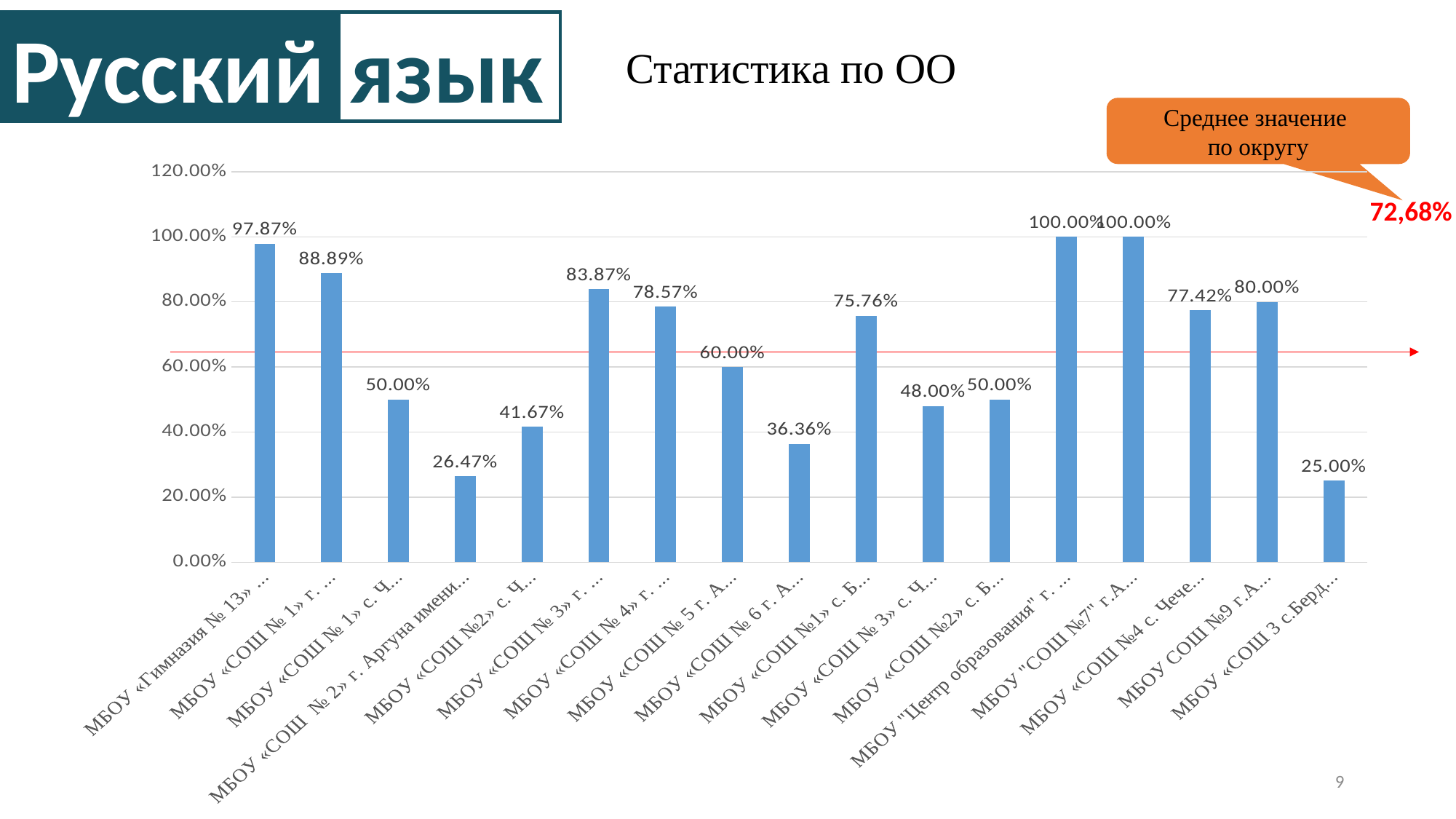
How many bars (educational organisations) are plotted in the chart? 17 What is the value for МБОУ «Гимназия № 13»? 97.87% What is the difference between the values for МБОУ «Гимназия № 13» and МБОУ «СОШ 3 с.Берд...»? 72.87% What type of chart is shown on the slide? bar chart What is the value for МБОУ "Центр образования"? 100.00% Which organisation has the lowest value in the chart? МБОУ «СОШ 3 с.Берд...» What is the title of the chart on the slide? Статистика по ОО What is the value for МБОУ «СОШ № 6 г. А...»? 36.36% Which is larger: the value for МБОУ «СОШ № 4» г. ... or the value for МБОУ «СОШ №4 с. Чече...»? МБОУ «СОШ № 4» г. ... What is the average value for the district (среднее значение по округу) shown on the slide? 72,68% What is the value for МБОУ СОШ №9 г.А...? 80.00% What is the value for МБОУ «СОШ № 2» г. Аргуна? 26.47%